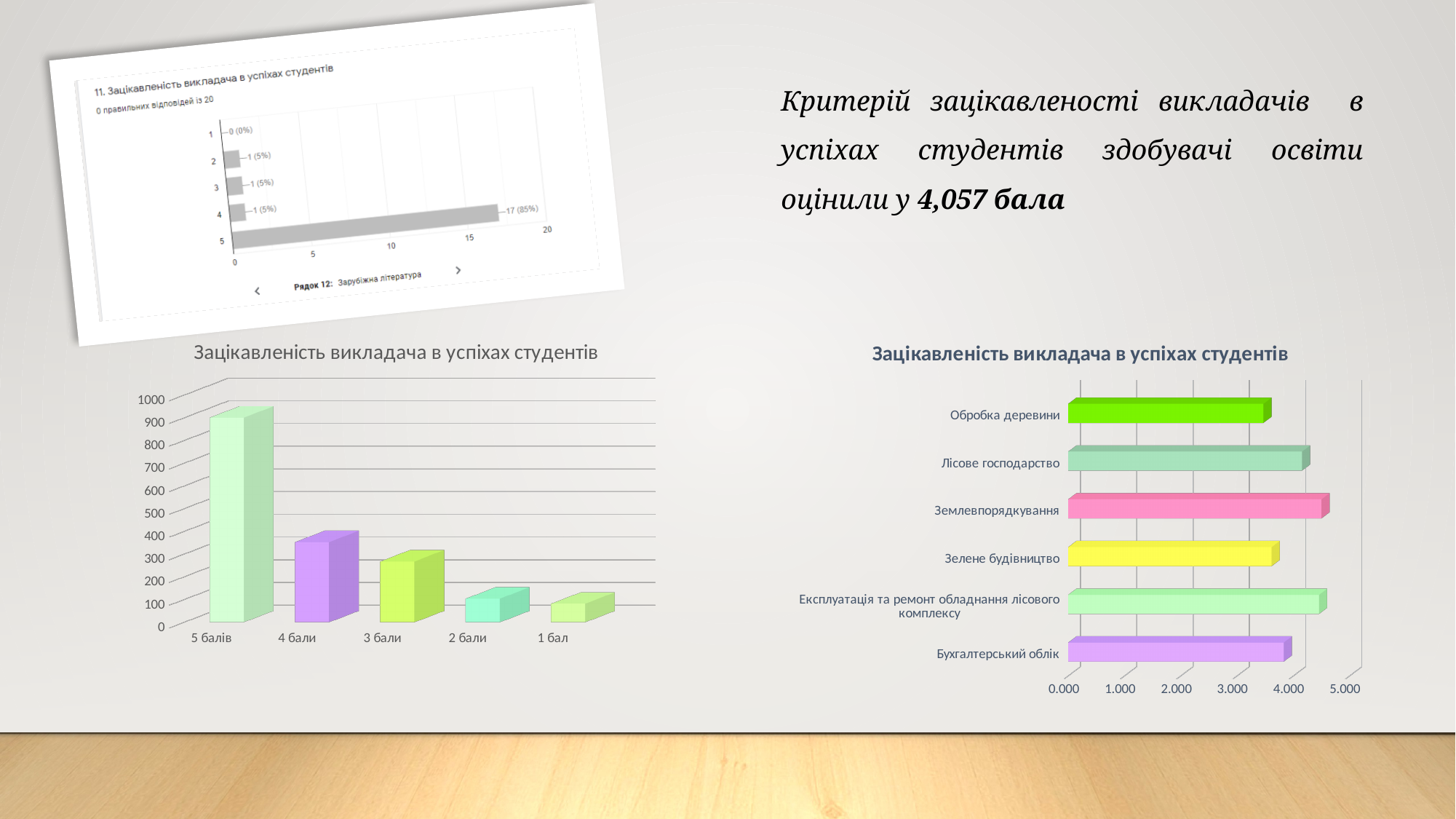
In the screenshot chart at the top left, how many responses are shown for rating 5? 17 (85%) In the bottom-left chart, is the value for '2 бали' greater or less than 200? less In the screenshot chart at the top left, which rating has the highest number of responses? 5 In the bottom-left chart, how many categories are shown on the x axis? 5 In the bottom-right chart, is the value for 'Обробка деревини' greater or less than 4.000? less In the bottom-left chart, is the value for '4 бали' greater or less than 500? less In the bottom-right chart, how many categories are listed? 6 In the bottom-left chart, do the values rise or fall from '5 балів' to '1 бал'? fall In the screenshot chart at the top left, how many responses are shown for rating 1? 0 (0%) In the bottom-left chart 'Зацікавленість викладача в успіхах студентів', which category has the tallest bar? 5 балів In the bottom-right chart, which is larger: the value for 'Лісове господарство' or for 'Обробка деревини'? Лісове господарство